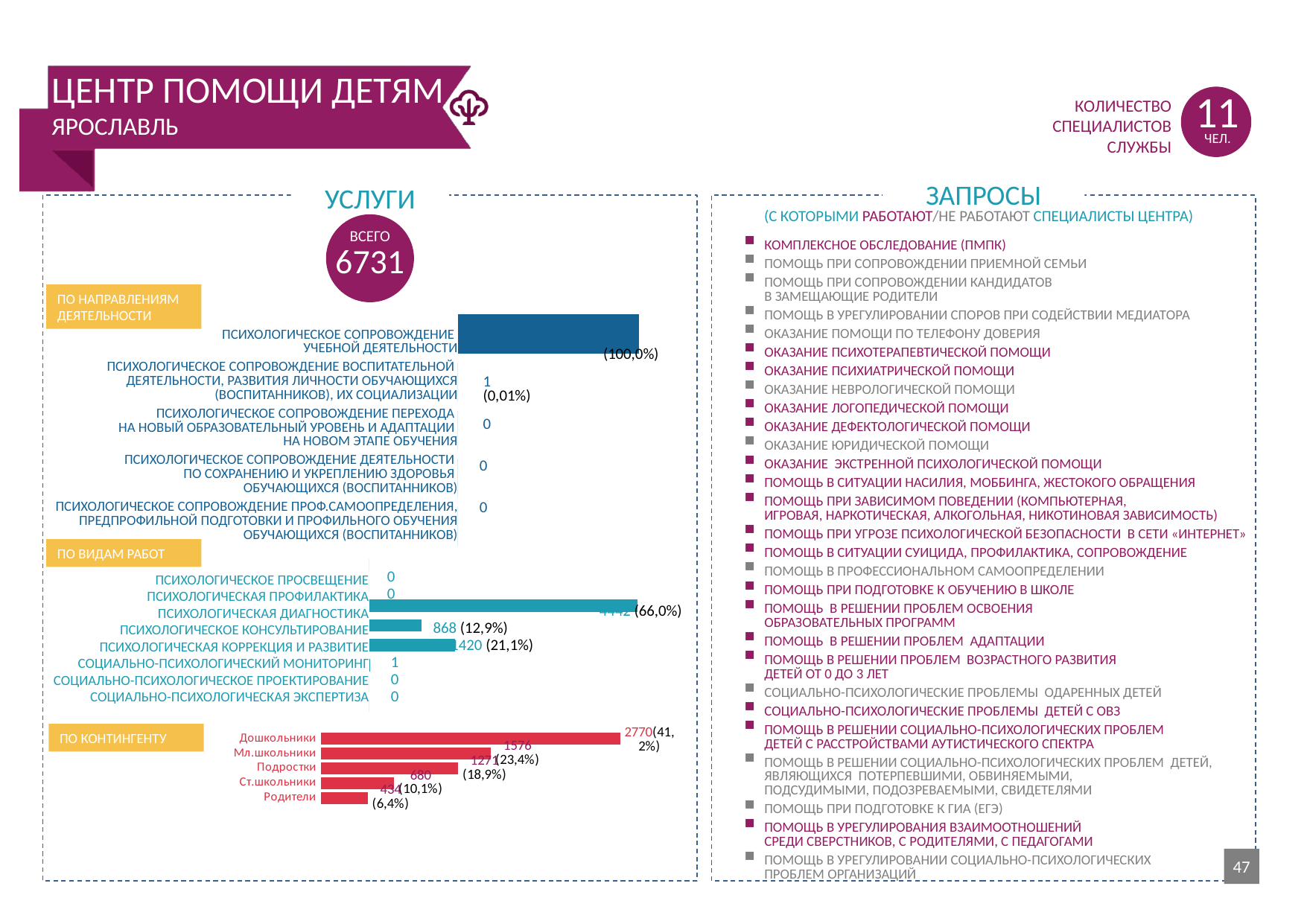
In the 'ПО НАПРАВЛЕНИЯМ ДЕЯТЕЛЬНОСТИ' chart, what percentage is shown for ПСИХОЛОГИЧЕСКОЕ СОПРОВОЖДЕНИЕ УЧЕБНОЙ ДЕЯТЕЛЬНОСТИ? (100,0%) In the 'ПО ВИДАМ РАБОТ' chart, how many categories are listed? 8 In the 'ПО КОНТИНГЕНТУ' chart, what is the value for Родители? 434 In the 'ПО КОНТИНГЕНТУ' chart, which category has the highest value? Дошкольники In the 'ПО ВИДАМ РАБОТ' chart, which is larger: ПСИХОЛОГИЧЕСКОЕ КОНСУЛЬТИРОВАНИЕ or ПСИХОЛОГИЧЕСКАЯ КОРРЕКЦИЯ И РАЗВИТИЕ? ПСИХОЛОГИЧЕСКАЯ КОРРЕКЦИЯ И РАЗВИТИЕ In the 'ПО КОНТИНГЕНТУ' chart, what is the value for Дошкольники? 2770 In the 'ПО КОНТИНГЕНТУ' chart, which category has the lowest value? Родители In the 'ПО КОНТИНГЕНТУ' chart, what is the difference between the values for Мл.школьники and Подростки? 305 In the 'ПО ВИДАМ РАБОТ' chart, what is the value for ПСИХОЛОГИЧЕСКАЯ КОРРЕКЦИЯ И РАЗВИТИЕ? 1420 What type of chart is the 'ПО КОНТИНГЕНТУ' chart? Bar chart In the 'ПО ВИДАМ РАБОТ' chart, what is the value for ПСИХОЛОГИЧЕСКОЕ КОНСУЛЬТИРОВАНИЕ? 868 In the 'ПО КОНТИНГЕНТУ' chart, what percentage is shown for Ст.школьники? (10,1%)